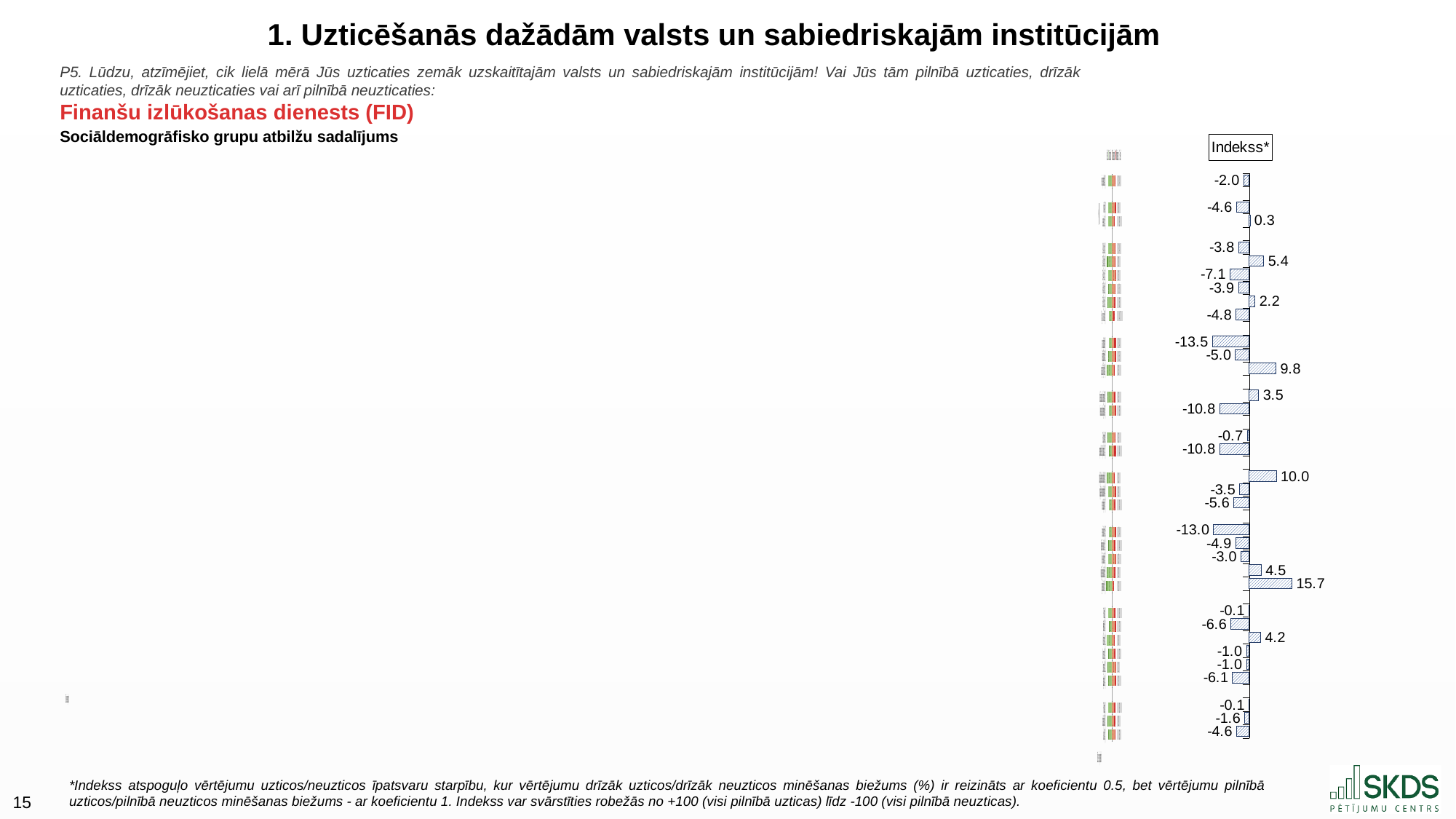
What is the lowest value shown in the Indekss* chart? -13.5 What kind of chart is the Indekss* chart on the right of the slide? bar chart What is the largest value shown in the Indekss* chart? 15.7 What is the second-highest value shown in the Indekss* chart? 10.0 How many bars in the Indekss* chart have a positive value? 9 What is the title shown above the index chart on the right? Indekss* Which institution is the slide's chart about, as shown in the red heading? Finanšu izlūkošanas dienests (FID) In the Indekss* chart, which is larger: the value 10.0 or the value 9.8? 10.0 In the Indekss* chart, which is larger: the value -13.0 or the value -13.5? -13.0 What is the difference between the highest value (15.7) and the lowest value (-13.5) in the Indekss* chart? 29.2